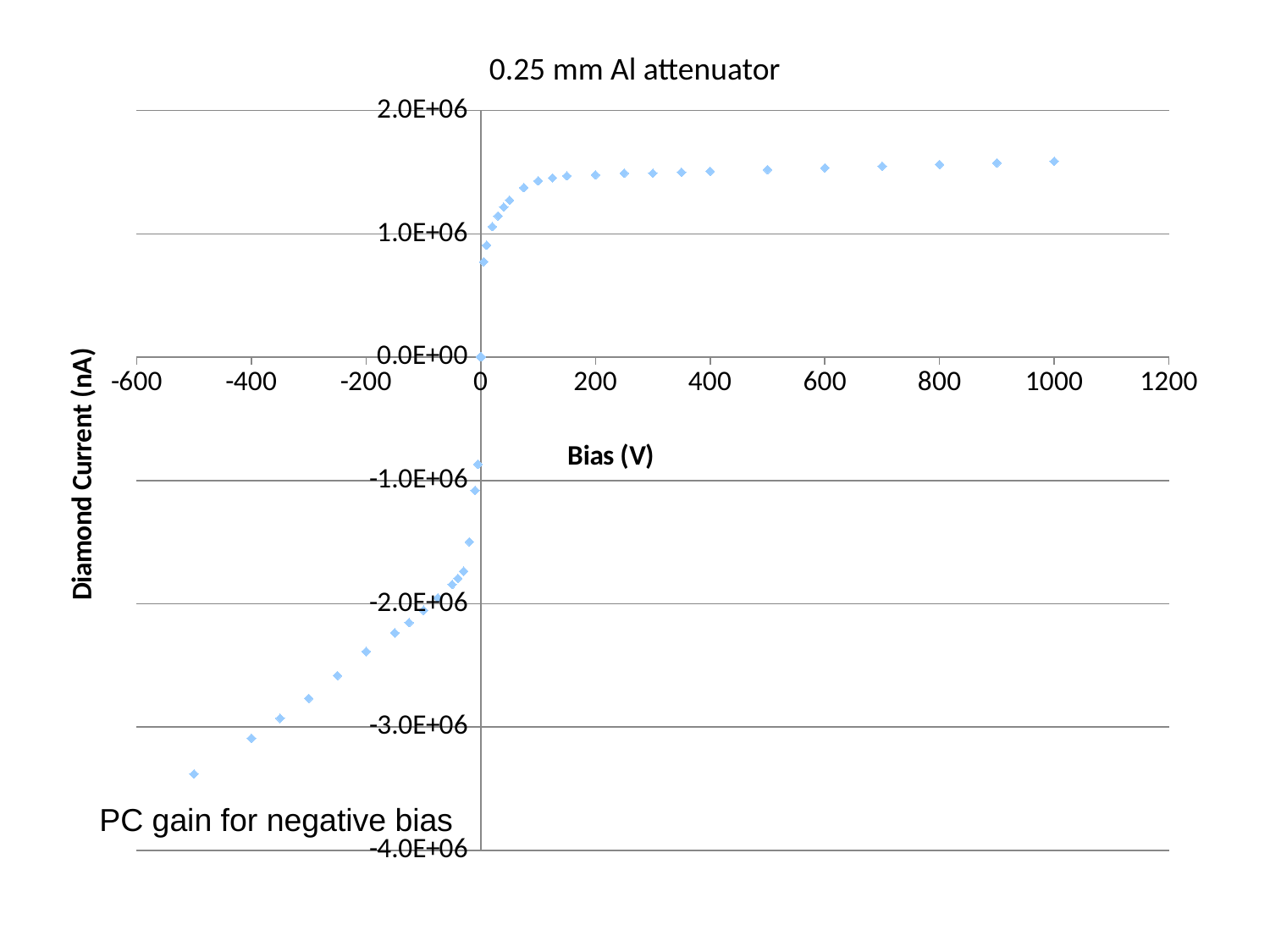
At which bias value is the diamond current highest? 1000 V Is the diamond current at a bias of -200 V greater or less than -2.0E+06 nA? less Is the diamond current at a bias of -300 V greater or less than -3.0E+06 nA? greater Is the diamond current at a bias of -500 V greater or less than -3.0E+06 nA? less For positive bias values, does the diamond current rise or fall as the bias increases? rise At which bias value is the diamond current lowest? -500 V What is the label of the x axis? Bias (V) What is the title of the chart? 0.25 mm Al attenuator Which has the larger diamond current: a bias of 1000 V or a bias of 200 V? 1000 V What kind of chart is shown on the slide? scatter chart